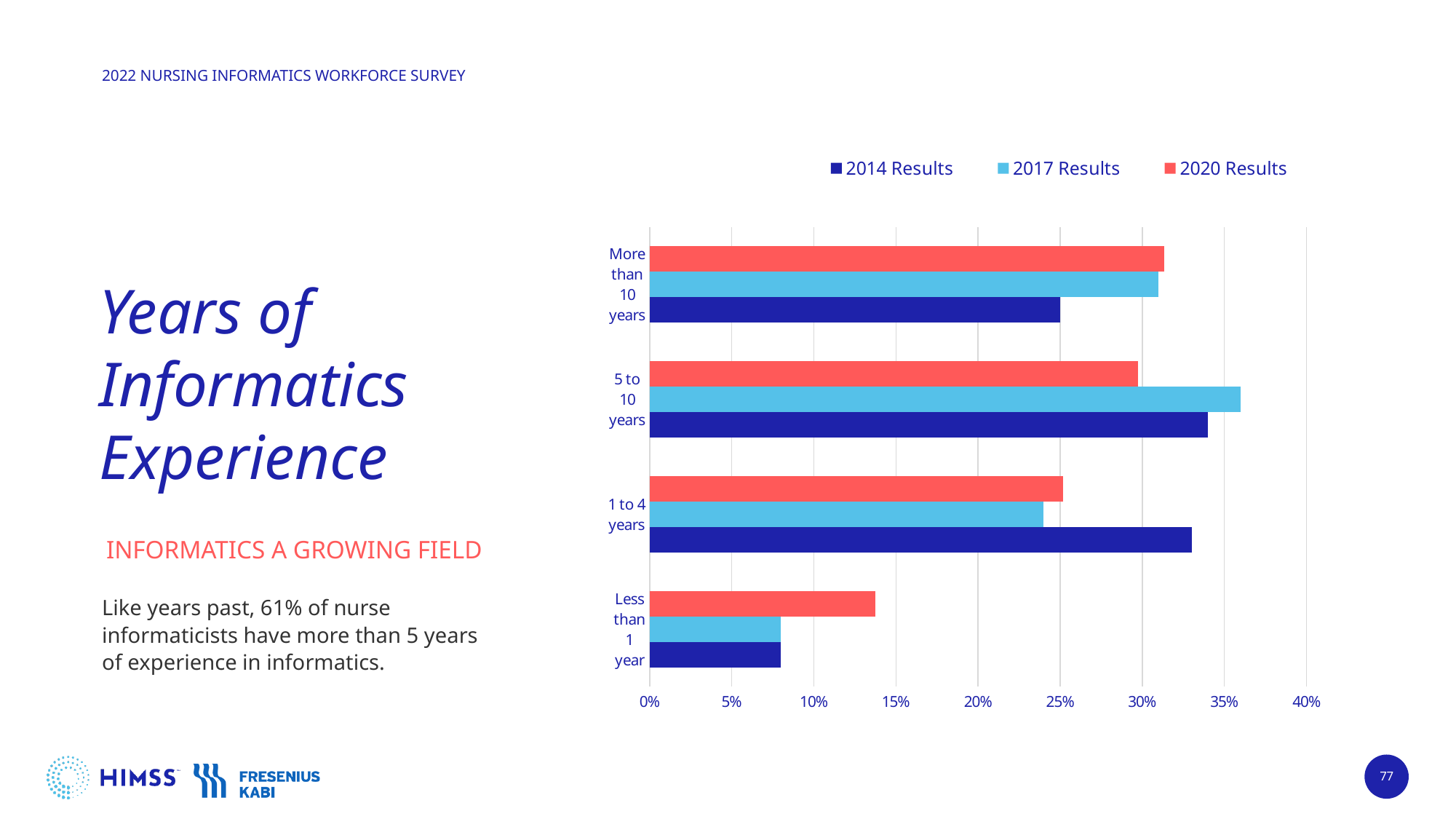
Which experience category has the highest 2017 Results value? 5 to 10 years For "5 to 10 years", which is larger: the 2017 Results value or the 2020 Results value? 2017 Results For "1 to 4 years", which is larger: the 2014 Results value or the 2017 Results value? 2014 Results What kind of chart is shown on the slide? bar chart Is the 2014 Results value for "Less than 1 year" greater or less than 10%? less Is the 2014 Results value for "More than 10 years" greater or less than 30%? less Is the 2017 Results value for "5 to 10 years" greater or less than 35%? greater What colour represents the 2020 Results series in the legend? red How many series does the legend list? 3 Which experience category has the lowest 2020 Results value? Less than 1 year How many experience categories are plotted on the chart? 4